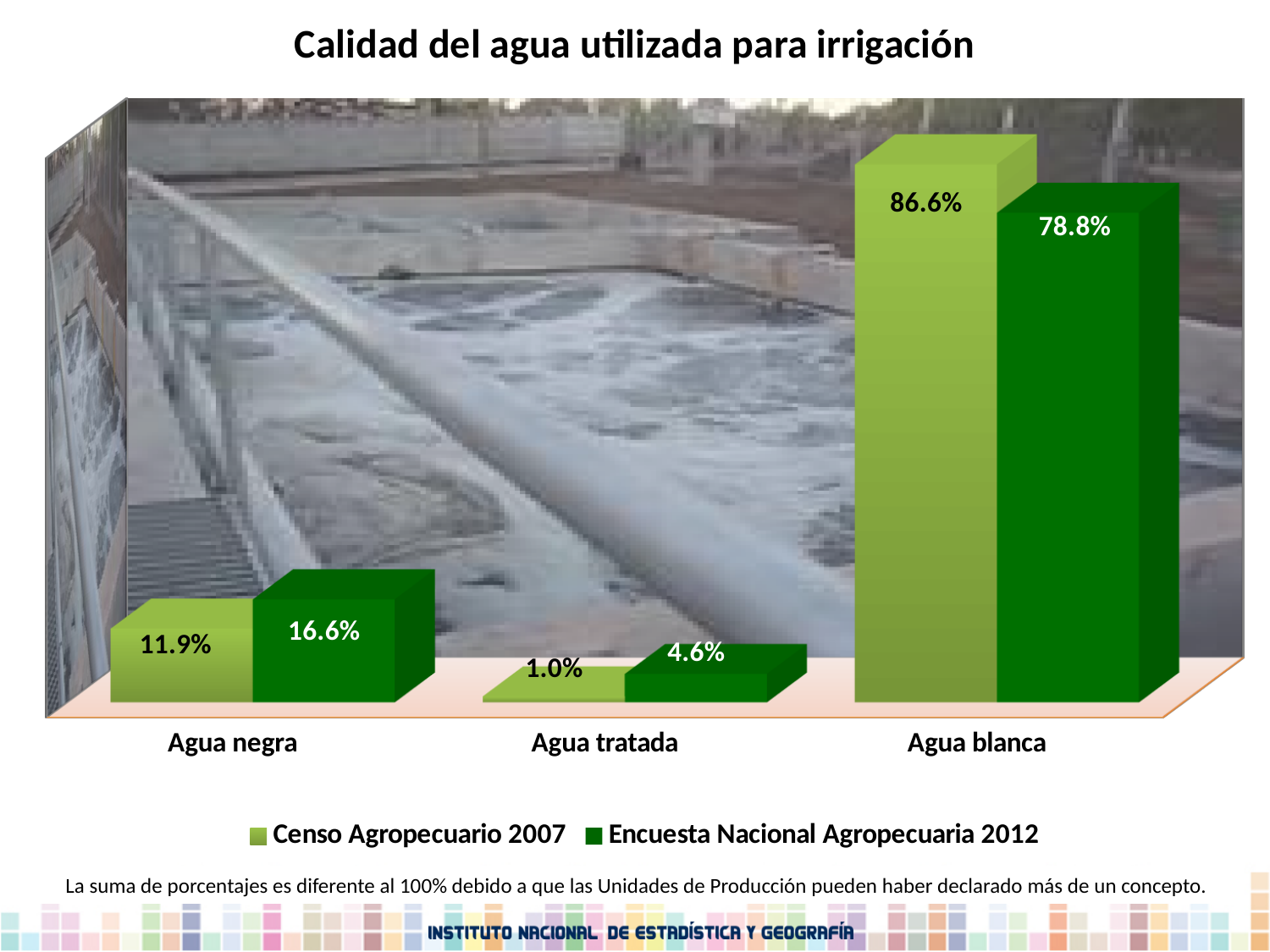
What is the value for Agua tratada in the Encuesta Nacional Agropecuaria 2012 series? 4.6% What is the value for Agua tratada in the Censo Agropecuario 2007 series? 1.0% How many categories are shown on the x axis? 3 How many series does the legend list? 2 For Agua negra, which series has the larger value: Censo Agropecuario 2007 or Encuesta Nacional Agropecuaria 2012? Encuesta Nacional Agropecuaria 2012 Which category has the highest value in the Censo Agropecuario 2007 series? Agua blanca What is the difference between the Encuesta Nacional Agropecuaria 2012 and Censo Agropecuario 2007 values for Agua negra? 4.7% What kind of chart is shown on the slide? Bar chart What is the value for Agua negra in the Censo Agropecuario 2007 series? 11.9% What is the difference between the Censo Agropecuario 2007 and Encuesta Nacional Agropecuaria 2012 values for Agua blanca? 7.8% What is the value for Agua blanca in the Encuesta Nacional Agropecuaria 2012 series? 78.8% Which category has the lowest value in the Encuesta Nacional Agropecuaria 2012 series? Agua tratada